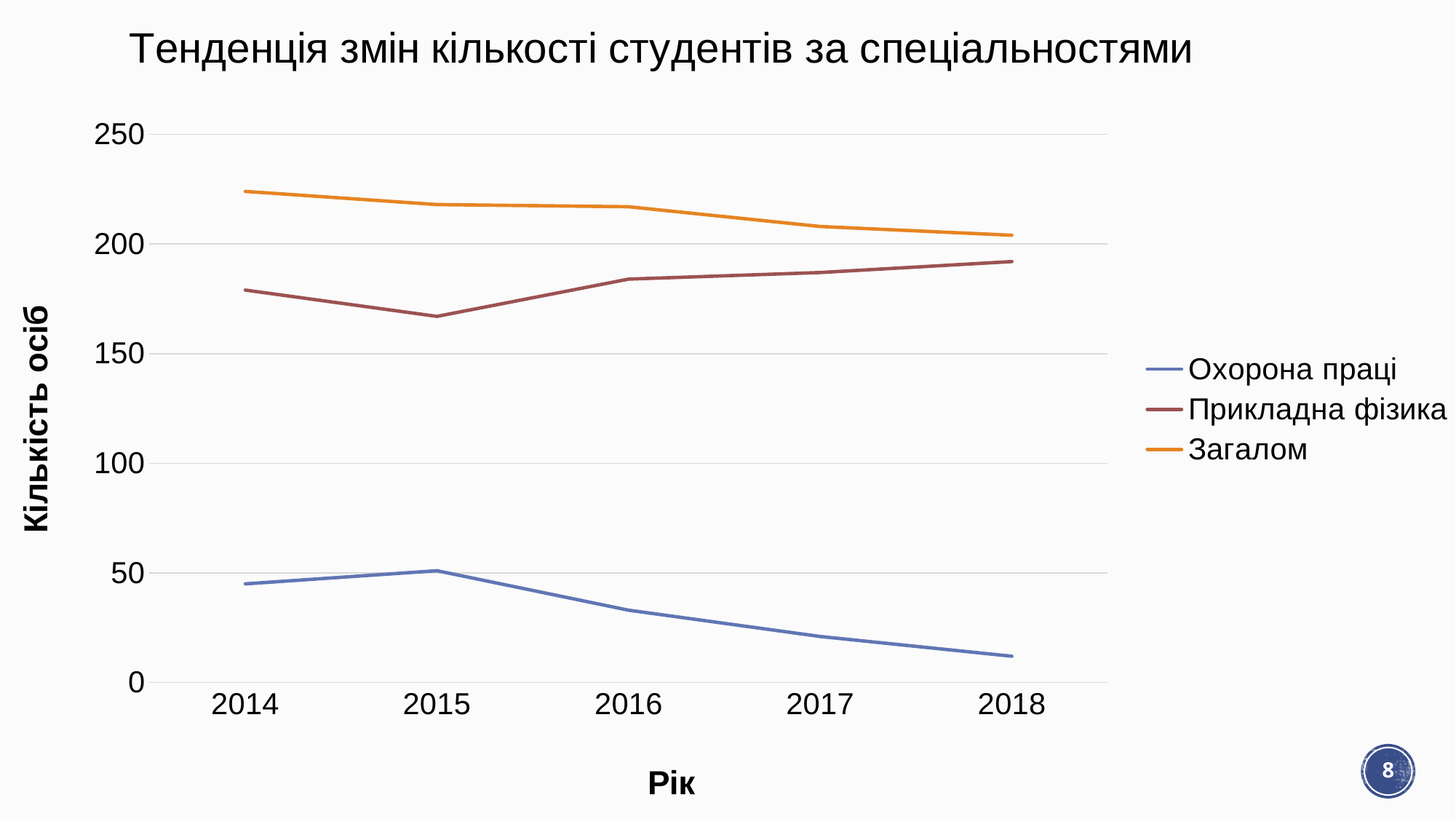
How many years are plotted along the x axis? 5 Is the value for Охорона праці in 2018 greater or less than 50? less Is the value for Загалом in 2014 greater or less than 200? greater What is the label of the y axis? Кількість осіб What kind of chart is shown on the slide? line chart How many series does the legend list? 3 Does the Загалом series rise or fall from 2014 to 2018? fall Is the value for Охорона праці in 2016 greater or less than 50? less In which year is the value for Загалом highest? 2014 In which year is the value for Прикладна фізика lowest? 2015 In which year is the value for Охорона праці lowest? 2018